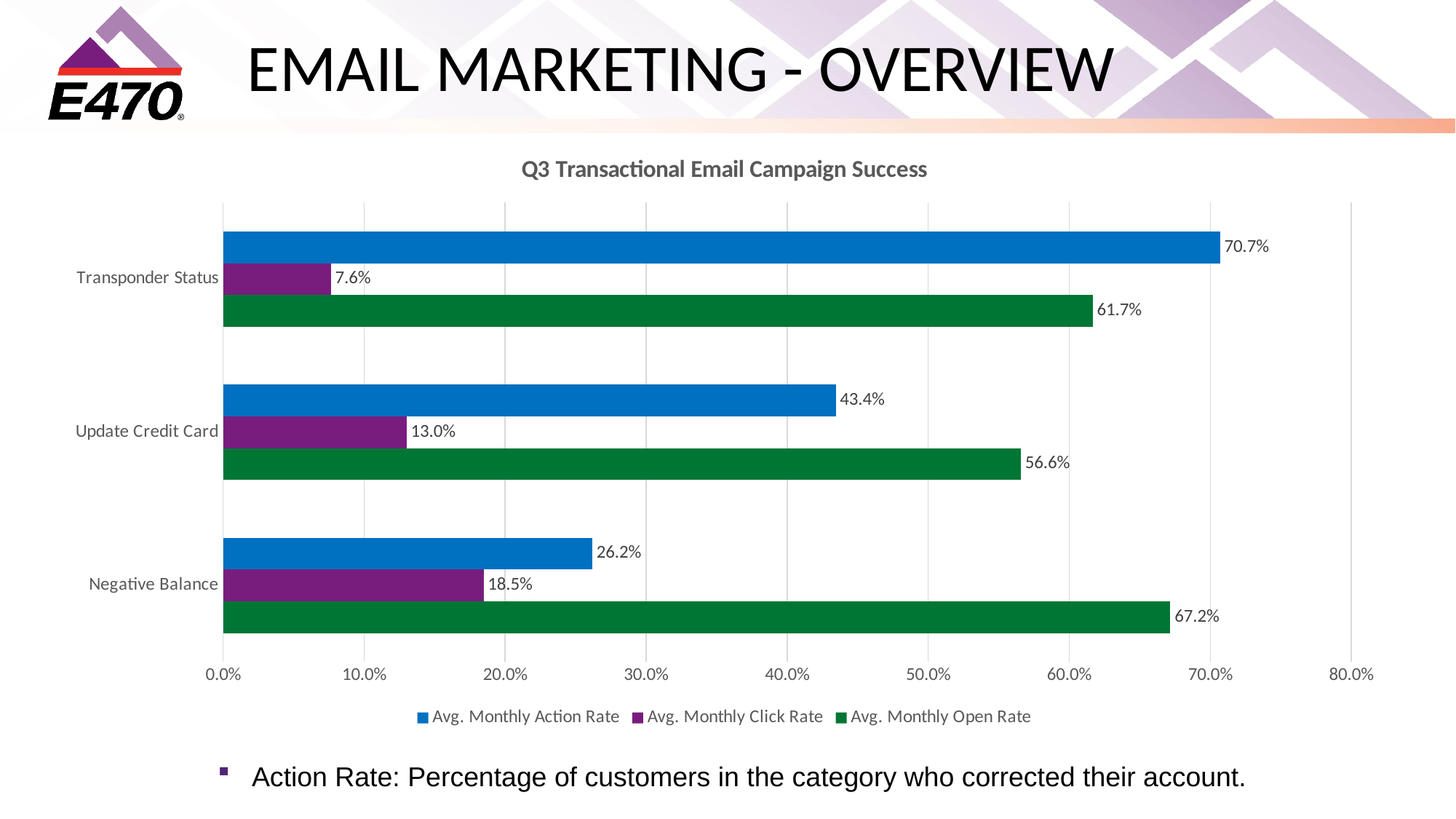
Which is larger for Transponder Status: the Avg. Monthly Action Rate or the Avg. Monthly Open Rate? Avg. Monthly Action Rate How many series does the legend list? 3 What is the Avg. Monthly Click Rate for Update Credit Card? 13.0% Is the Avg. Monthly Action Rate for Update Credit Card greater or less than 40.0%? greater What is the difference between the Avg. Monthly Open Rate and the Avg. Monthly Action Rate for Update Credit Card? 13.2% What is the title of the chart? Q3 Transactional Email Campaign Success Which category has the highest Avg. Monthly Click Rate? Negative Balance What kind of chart is shown on the slide? Bar chart What is the Avg. Monthly Action Rate for Transponder Status? 70.7% Which category has the lowest Avg. Monthly Action Rate? Negative Balance How many categories are shown on the chart? 3 What is the Avg. Monthly Open Rate for Negative Balance? 67.2%